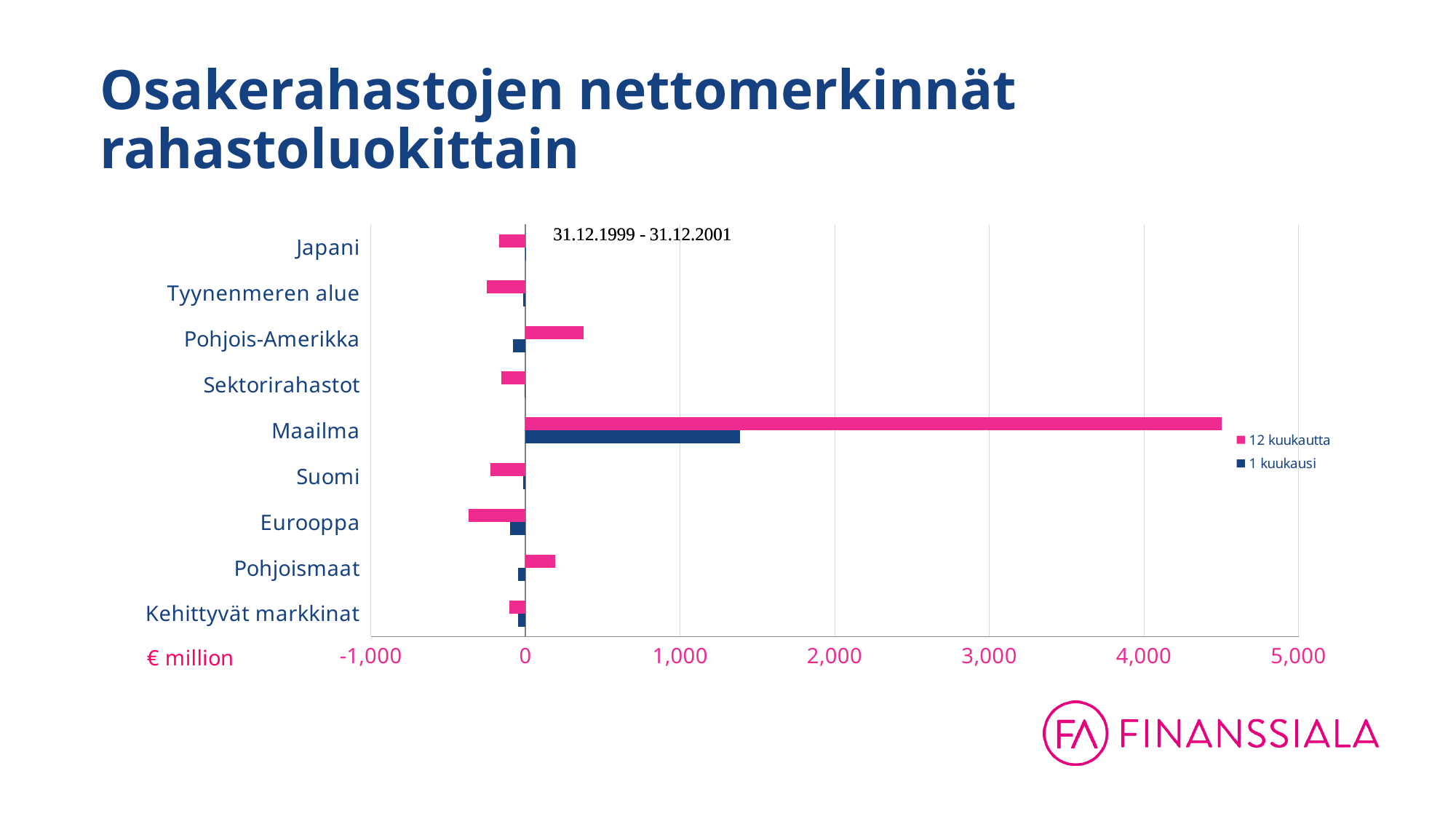
How many series does the chart's legend list? 2 For the 12 kuukautta series, which is larger: Pohjois-Amerikka or Pohjoismaat? Pohjois-Amerikka Is the 12 kuukautta value for Maailma greater or less than 4,000? greater Which category has the highest value for the 12 kuukautta series? Maailma What kind of chart is shown on the slide? bar chart What unit is shown for the horizontal axis of the chart? € million Which category has the highest value for the 1 kuukausi series? Maailma What date range is printed on the chart? 31.12.1999 - 31.12.2001 Is the 1 kuukausi value for Maailma greater or less than 1,000? greater How many fund categories are listed on the chart's vertical axis? 9 Which category has the lowest (most negative) value for the 12 kuukautta series? Eurooppa Is the 12 kuukautta value for Pohjois-Amerikka greater or less than 1,000? less